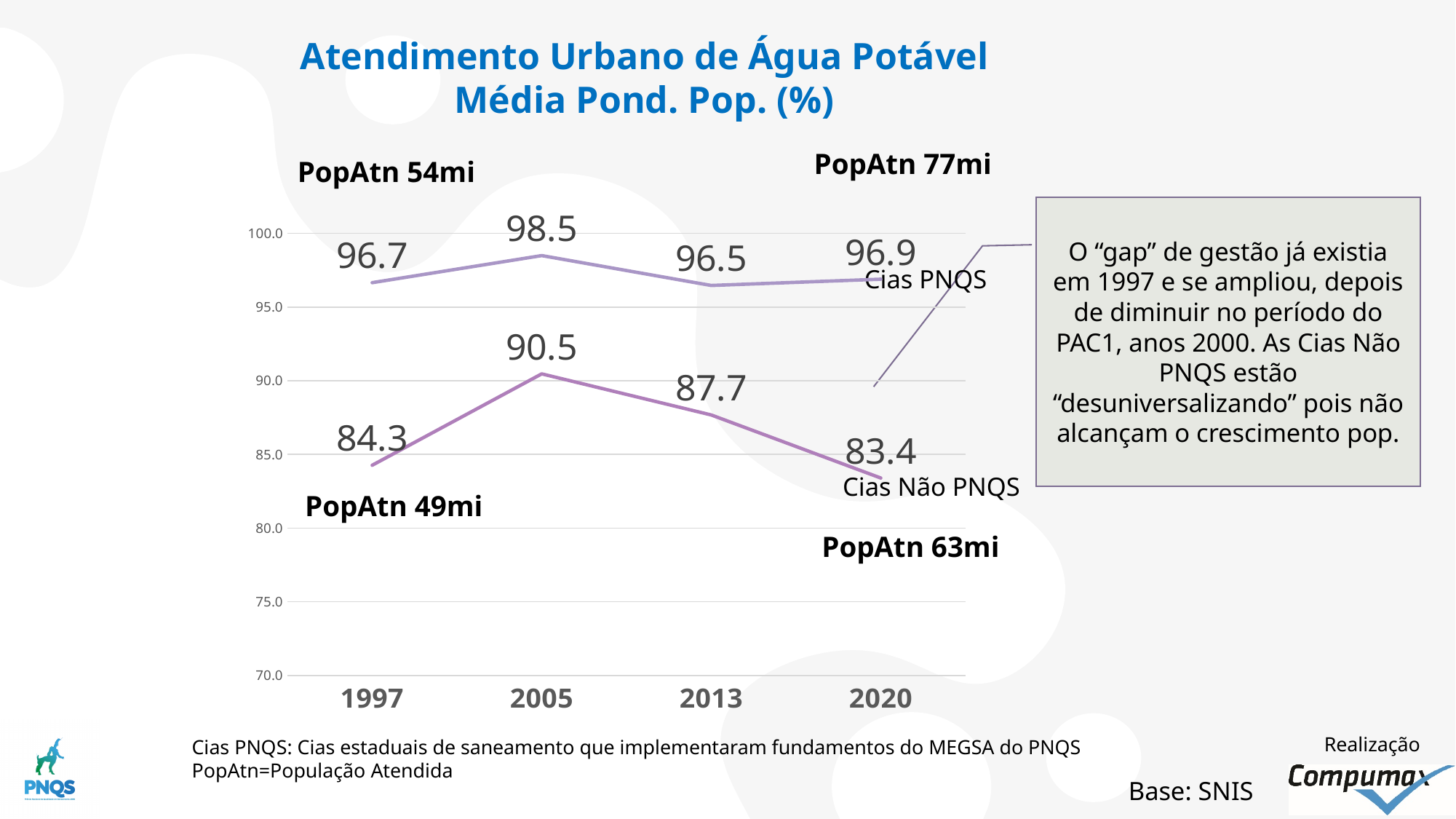
What is the value for Cias Não PNQS in 2020? 83.4 Does the Cias Não PNQS line rise or fall from 2005 to 2020? fall In which year is the Cias Não PNQS value lowest? 2020 What is the difference between Cias PNQS and Cias Não PNQS in 2020? 13.5 How many years are shown on the x axis? 4 In which year is the Cias Não PNQS value highest? 2005 What is the value for Cias PNQS in 1997? 96.7 What is the difference between the Cias Não PNQS values in 2005 and 2013? 2.8 Which is larger in 2013, Cias PNQS or Cias Não PNQS? Cias PNQS What is the value for Cias PNQS in 2005? 98.5 What kind of chart is shown on the slide? line chart Is the value for Cias Não PNQS in 1997 greater or less than 85.0? less